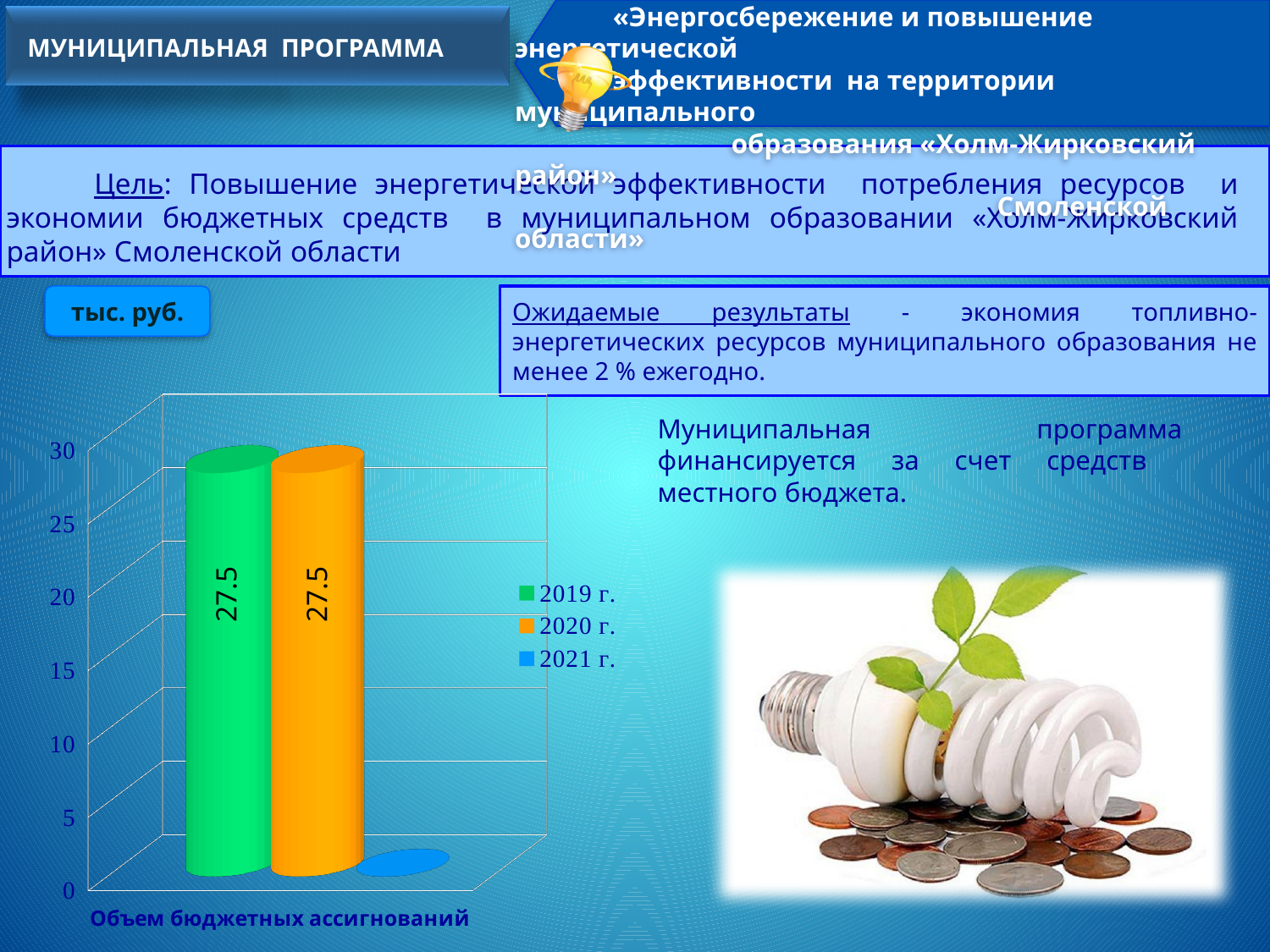
Is the value for 2020 г. greater or less than 25? greater What is the category label shown below the chart? Объем бюджетных ассигнований Which series has the lowest value in the chart? 2021 г. Which is larger, the value for 2019 г. or the value for 2021 г.? 2019 г. What is the value for 2020 г. in the bar chart? 27.5 How many categories are shown on the x axis of the chart? 1 What is the difference between the values for 2019 г. and 2020 г.? 0 What kind of chart is shown on the slide? bar chart Is the value for 2021 г. greater or less than 5? less What colour represents 2020 г. in the chart legend? orange What is the value for 2019 г. in the bar chart? 27.5 How many series does the chart legend list? 3